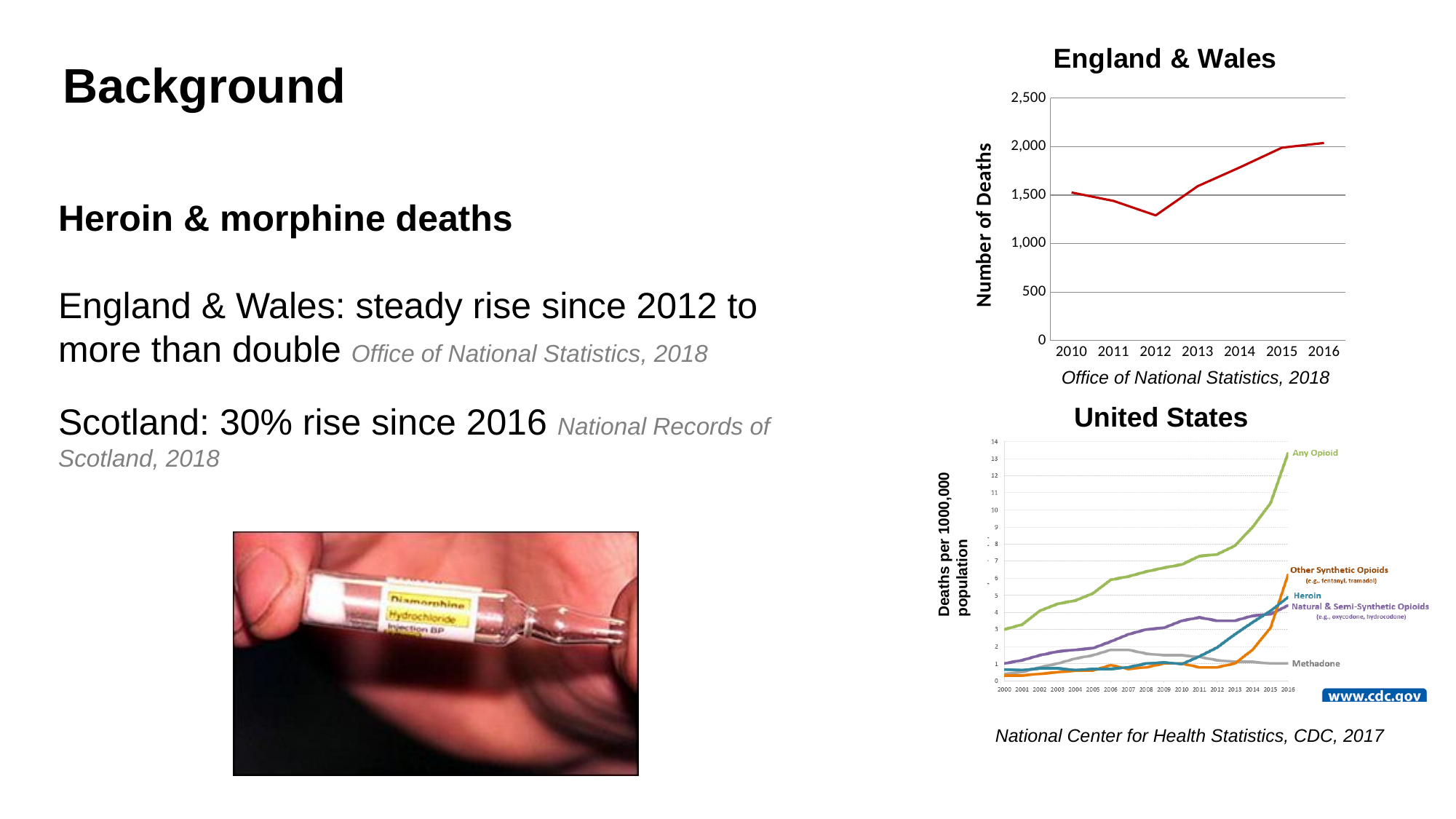
What is the y-axis label of the England & Wales chart? Number of Deaths In the United States chart, which series has the highest value in 2016? Any Opioid In the England & Wales chart, do the number of deaths rise or fall from 2012 to 2016? rise In the England & Wales chart, is the value for 2012 greater or less than 1,500? less In the England & Wales chart, which year has the lowest number of deaths? 2012 In the United States chart, is the value for Any Opioid in 2016 greater or less than 10? greater In the England & Wales chart, how many years are shown on the x axis? 7 In the United States chart, which series has the lowest value in 2016? Methadone In the United States chart, how many series are plotted? 5 In the England & Wales chart, is the value for 2014 greater or less than 1,500? greater What kind of chart is the England & Wales chart? line chart In the England & Wales chart, which year has the larger number of deaths, 2010 or 2012? 2010